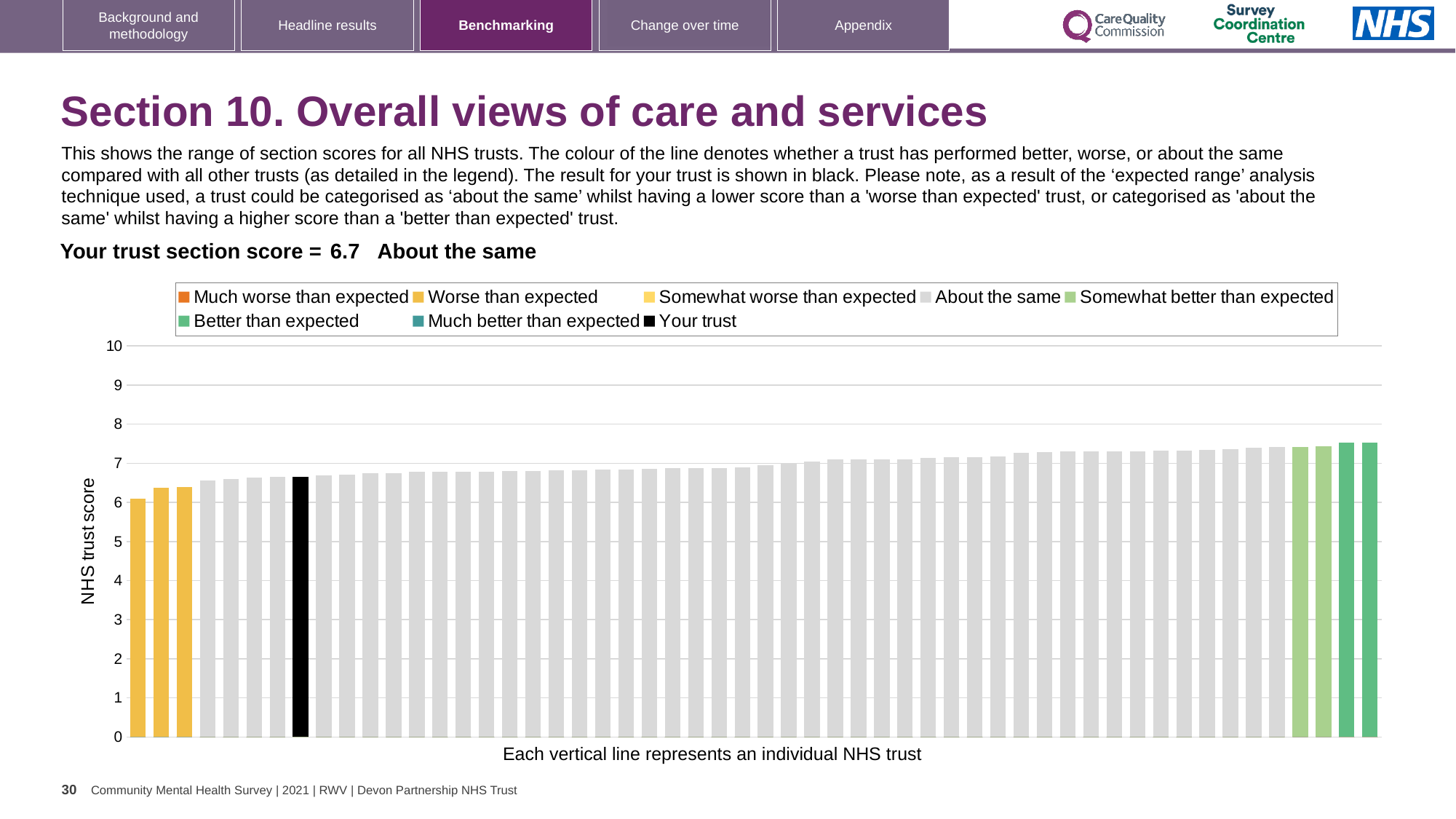
What is the label on the vertical axis of the chart? NHS trust score Is the value for your trust greater or less than 7? less Do the bar values rise or fall from left to right along the x axis? rise What is the section score for your trust shown on the slide? 6.7 How many entries does the chart legend list? 8 Is the value of the highest bar greater or less than 8? less Is the value for your trust greater or less than 6? greater What kind of chart is shown on the slide? bar chart What colour is the bar representing your trust? black Which category is your trust placed in for this section? About the same How many bars are coloured as 'Worse than expected'? 3